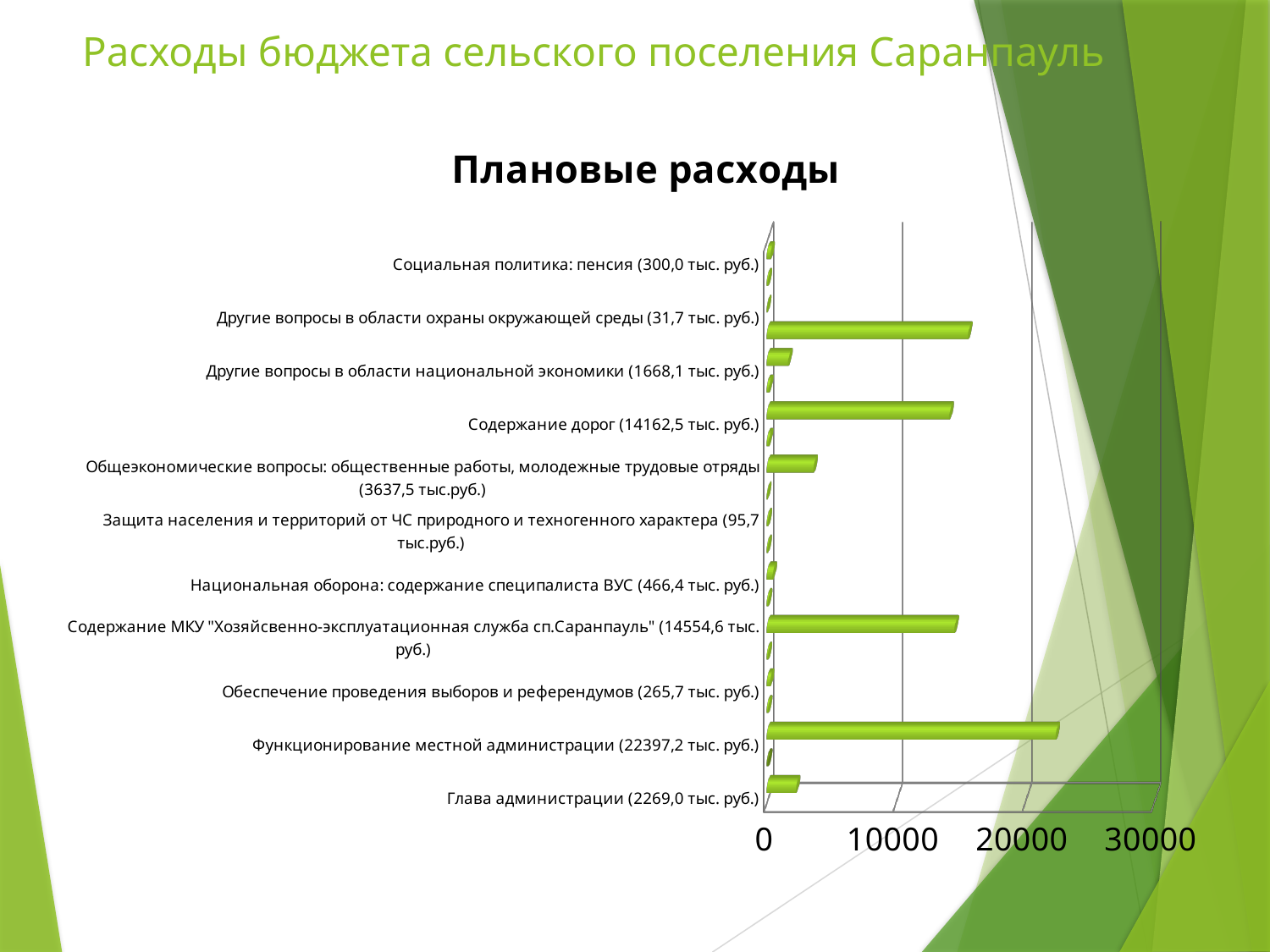
Is the value for Функционирование местной администрации greater or less than 20000? greater Is the value for Содержание дорог greater or less than 20000? less What is the planned expenditure for Общеэкономические вопросы: общественные работы, молодежные трудовые отряды? 3637,5 тыс.руб. Which is larger: the expenditure for Содержание МКУ "Хозяйсвенно-эксплуатационная служба сп.Саранпауль" or for Содержание дорог? Содержание МКУ "Хозяйсвенно-эксплуатационная служба сп.Саранпауль" What is the planned expenditure for Содержание дорог? 14162,5 тыс. руб. What is the title of the chart? Плановые расходы What is the planned expenditure for Функционирование местной администрации? 22397,2 тыс. руб. What kind of chart is shown on the slide? bar chart What is the difference between the expenditure for Функционирование местной администрации and Содержание дорог? 8234,7 тыс. руб. What is the planned expenditure for Глава администрации? 2269,0 тыс. руб. Which category has the highest planned expenditure? Функционирование местной администрации